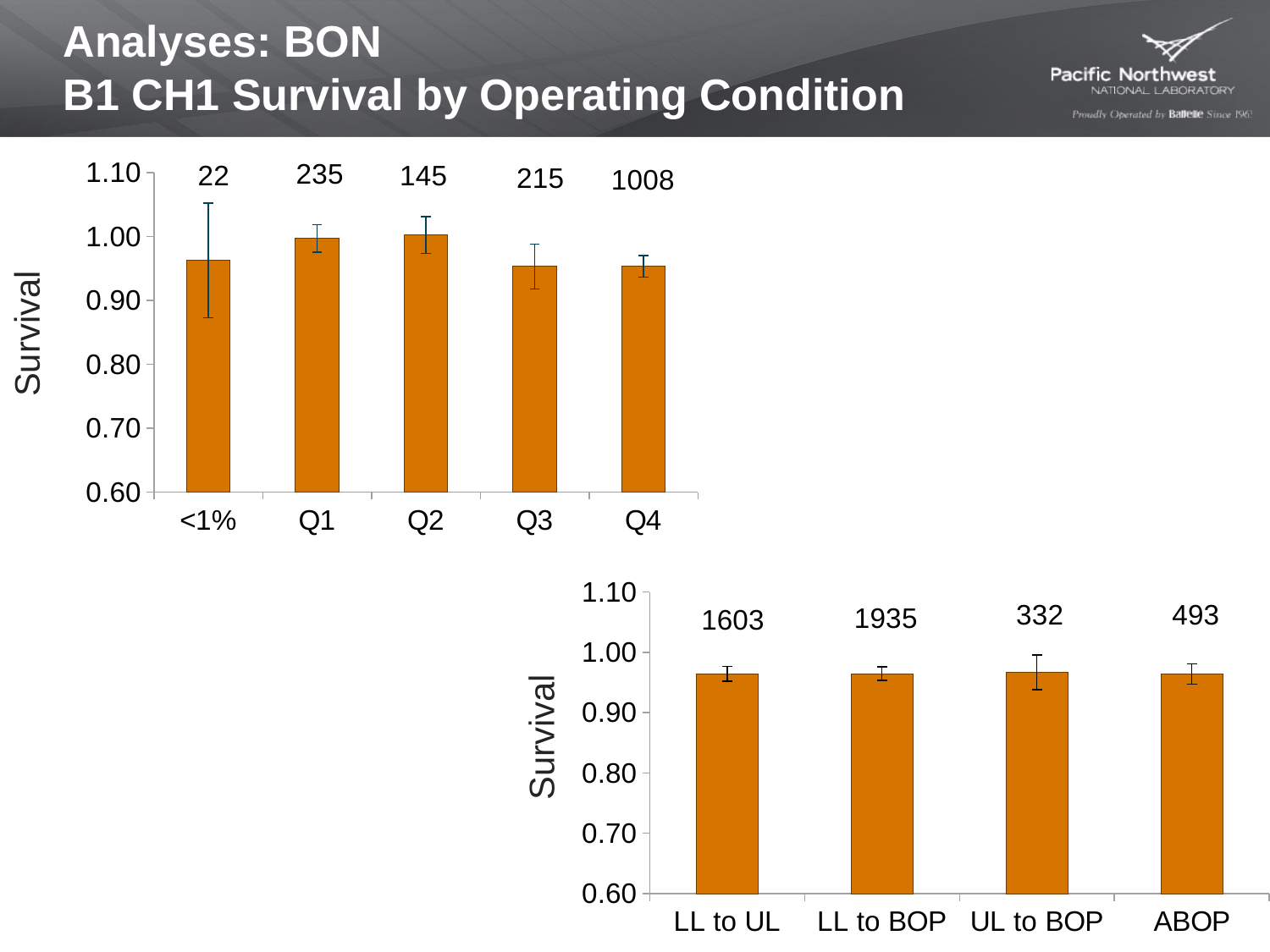
What kind of chart is the top-left chart? bar chart In the top-left chart, what number is printed above the bar for <1%? 22 In the top-left chart, which bar is taller, Q2 or Q3? Q2 In the top-left chart, how many categories are shown on the x axis? 5 In the top-left chart, is the survival value for Q3 greater or less than 1.00? less What is the label on the y axis of the bottom-right chart? Survival In the top-left chart, what number is printed above the bar for Q4? 1008 In the bottom-right chart, what number is printed above the bar for LL to BOP? 1935 In the bottom-right chart, is the survival value for ABOP greater or less than 1.00? less In the top-left chart, is the survival value for Q1 greater or less than 0.90? greater In the bottom-right chart, what number is printed above the bar for UL to BOP? 332 In the bottom-right chart, how many categories are shown on the x axis? 4